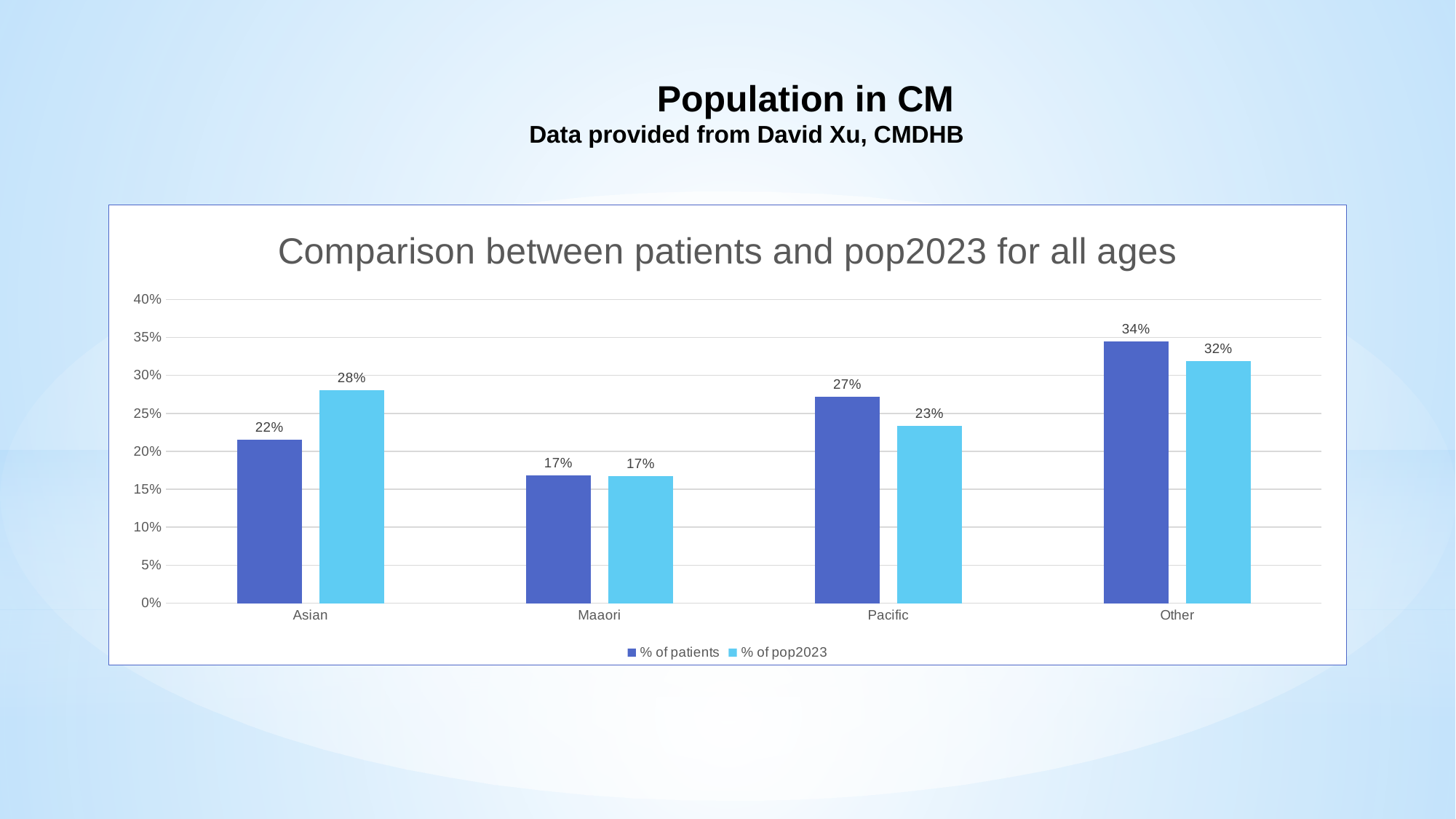
What is the % of patients value for Asian? 22% How many series does the legend list? 2 What kind of chart is shown on the slide? Bar chart What is the % of pop2023 value for Other? 32% How many categories are shown on the x axis? 4 Which category has the lowest % of pop2023? Maaori Which category has the highest % of patients? Other What is the difference between the % of patients and the % of pop2023 for Pacific? 4% What is the % of pop2023 value for Pacific? 23% What is the difference between the % of pop2023 and the % of patients for Asian? 6% What is the title of the chart? Comparison between patients and pop2023 for all ages Which is larger for Other: % of patients or % of pop2023? % of patients